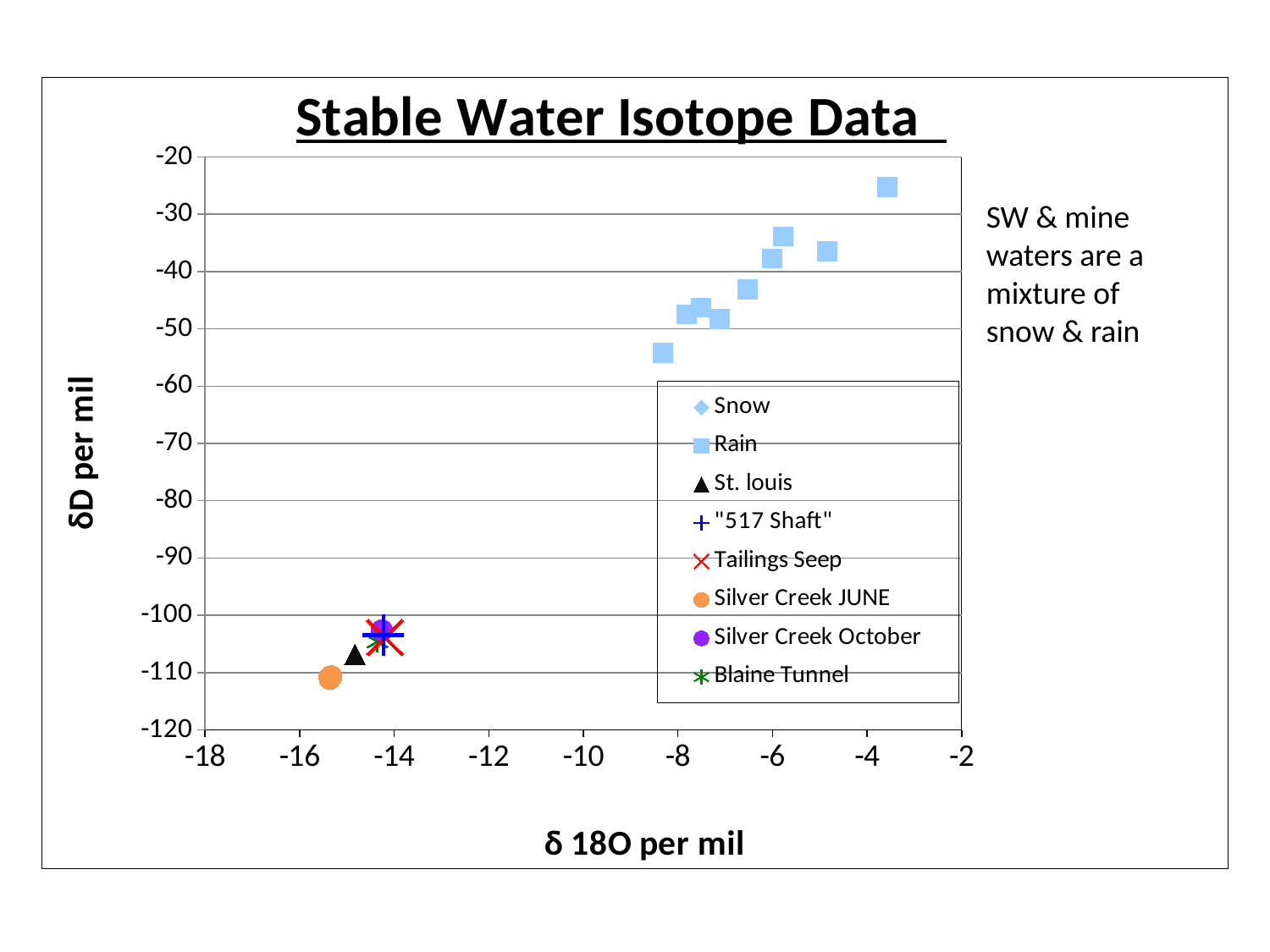
What is the title of the chart? Stable Water Isotope Data What is the label of the horizontal axis? δ 18O per mil How many series does the legend list? 8 Is the δ 18O value for Silver Creek JUNE greater or less than -14? less What kind of chart is shown on the slide? scatter chart Which series contains the point with the highest δD value? Rain Do the Rain points rise or fall in δD as δ 18O increases along the x axis? rise Is the δD value for Silver Creek JUNE greater or less than -100? less Is the δD value for St. louis greater or less than -100? less Which series has the lowest δD value on the chart? Silver Creek JUNE Which has a higher δD value, St. louis or Silver Creek JUNE? St. louis